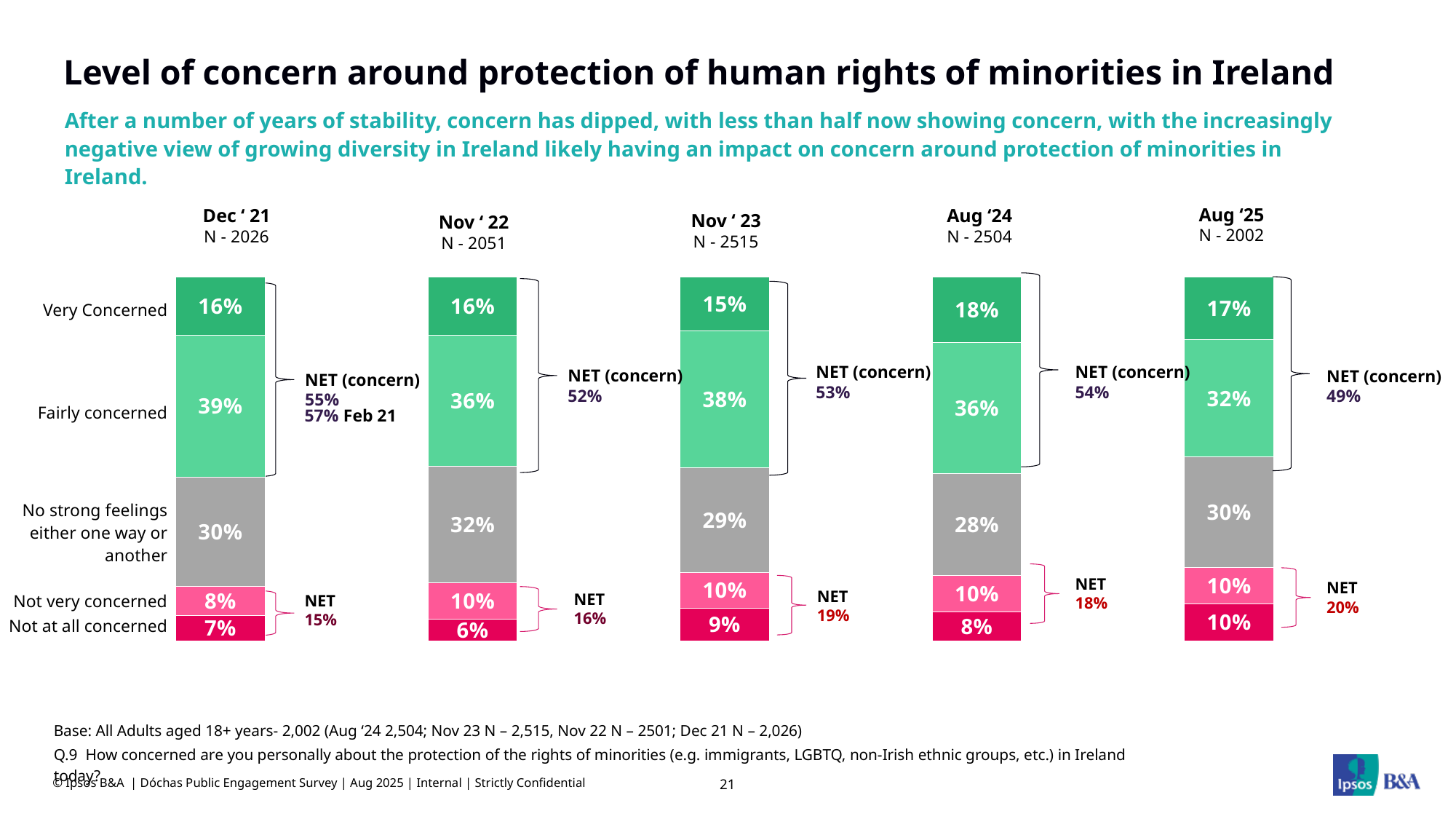
How many survey waves are shown in the chart? 5 What percentage had No strong feelings either one way or another in Nov '23? 29% Which wave has the highest NET (concern) figure? Dec '21 What percentage were Very Concerned in Aug '24? 18% Which wave has the lowest NET (concern) figure? Aug '25 What percentage were Fairly concerned in Aug '25? 32% What is the sample size (N) shown for Nov '23? 2515 What is the combined NET of Not very concerned and Not at all concerned in Aug '25? 20% Which is larger: the Not at all concerned percentage in Nov '23 or in Aug '24? Nov '23 What type of chart is used on this slide? Stacked bar chart What is the difference between the Fairly concerned percentage in Dec '21 and in Aug '25? 7 percentage points What is the NET (concern) figure for Nov '22? 52%